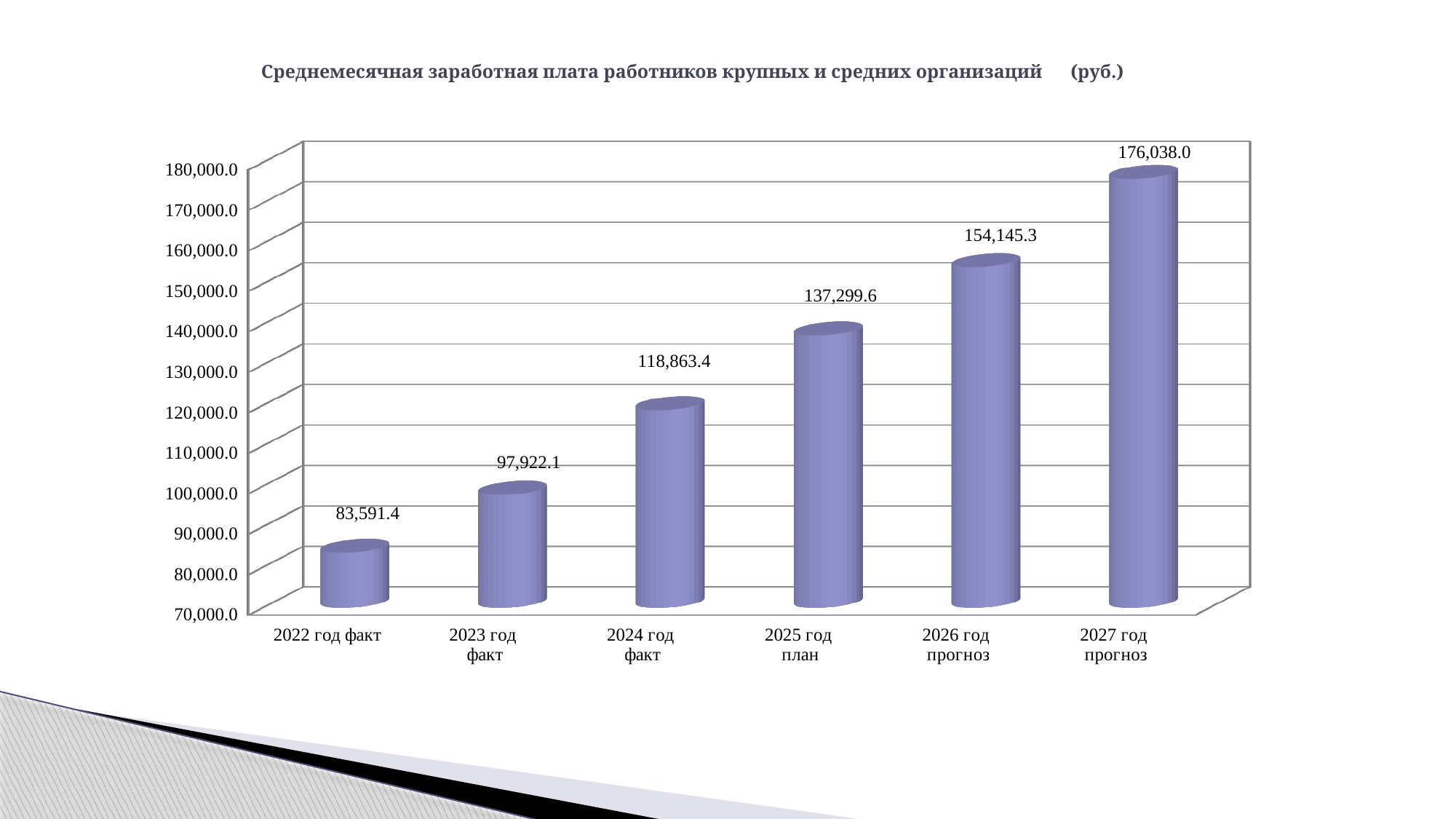
Which category has the lowest value? 2022 год факт Which is larger, the value for 2024 год факт or the value for 2023 год факт? 2024 год факт Is the value for 2026 год прогноз greater or less than 150,000.0? greater What kind of chart is shown on the slide? bar chart What is the value for 2027 год прогноз? 176,038.0 Do the values rise or fall from 2022 год факт to 2027 год прогноз? rise Which category has the highest value? 2027 год прогноз What is the value for 2025 год план? 137,299.6 How many categories are shown on the x axis? 6 What is the difference between the values for 2027 год прогноз and 2022 год факт? 92,446.6 What is the difference between the values for 2026 год прогноз and 2025 год план? 16,845.7 What is the value for 2022 год факт? 83,591.4